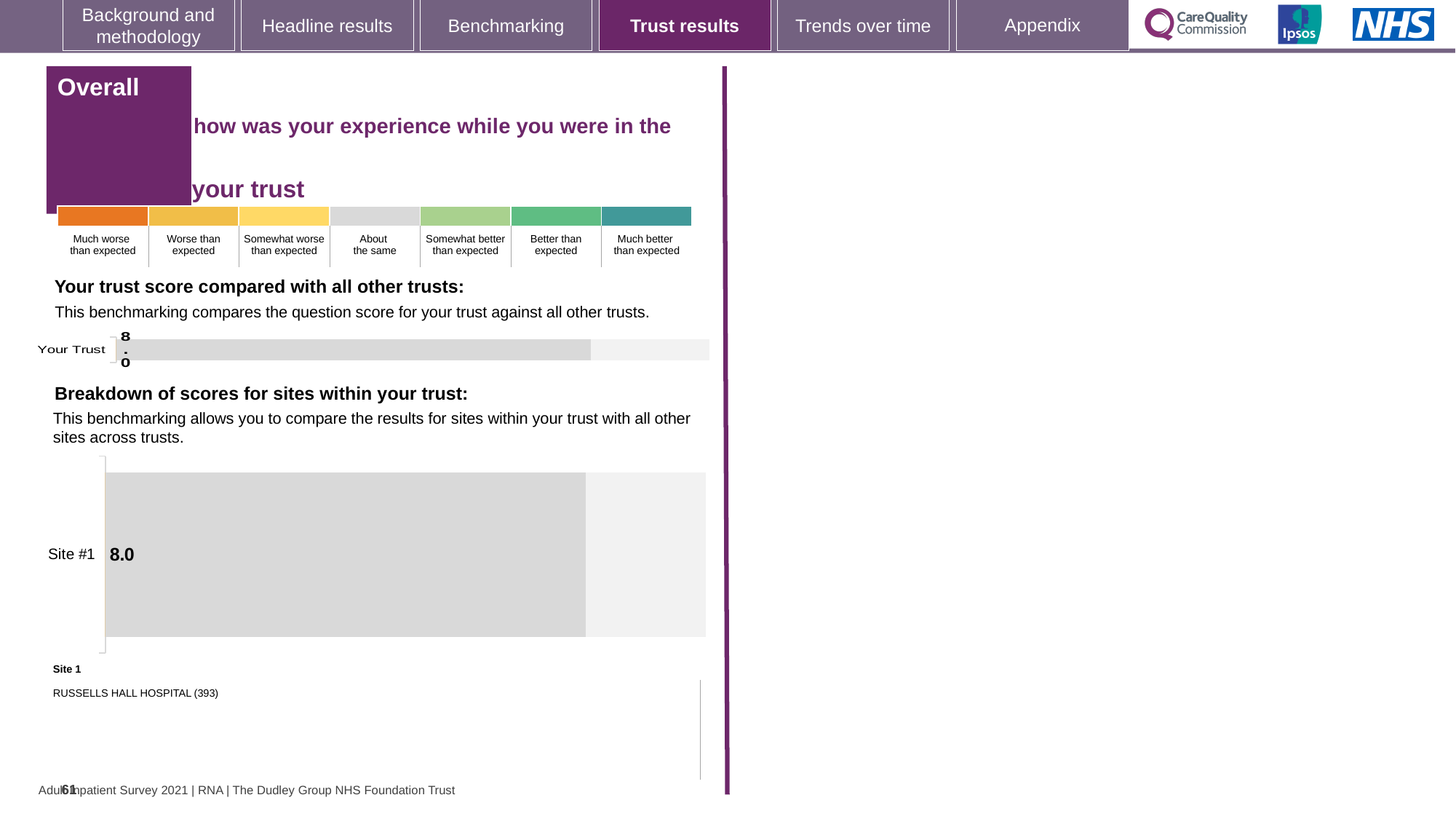
How many bars are plotted in the 'Your trust score compared with all other trusts' chart? 1 How many sites are plotted in the 'Breakdown of scores for sites within your trust' chart? 1 What kind of chart is the 'Breakdown of scores for sites within your trust' chart? bar chart What kind of chart is the 'Your trust score compared with all other trusts' chart? bar chart In the 'Your trust score compared with all other trusts' chart, what is the score for Your Trust? 8.0 In the 'Breakdown of scores for sites within your trust' chart, what is the score for Site #1? 8.0 How many rating categories does the colour key above the charts list? 7 What is the name of the hospital listed as Site 1 below the 'Breakdown of scores for sites within your trust' chart? RUSSELLS HALL HOSPITAL Is the score for Site #1 in the 'Breakdown of scores for sites within your trust' chart the same as the Your Trust score in the chart above it? Yes, both are 8.0